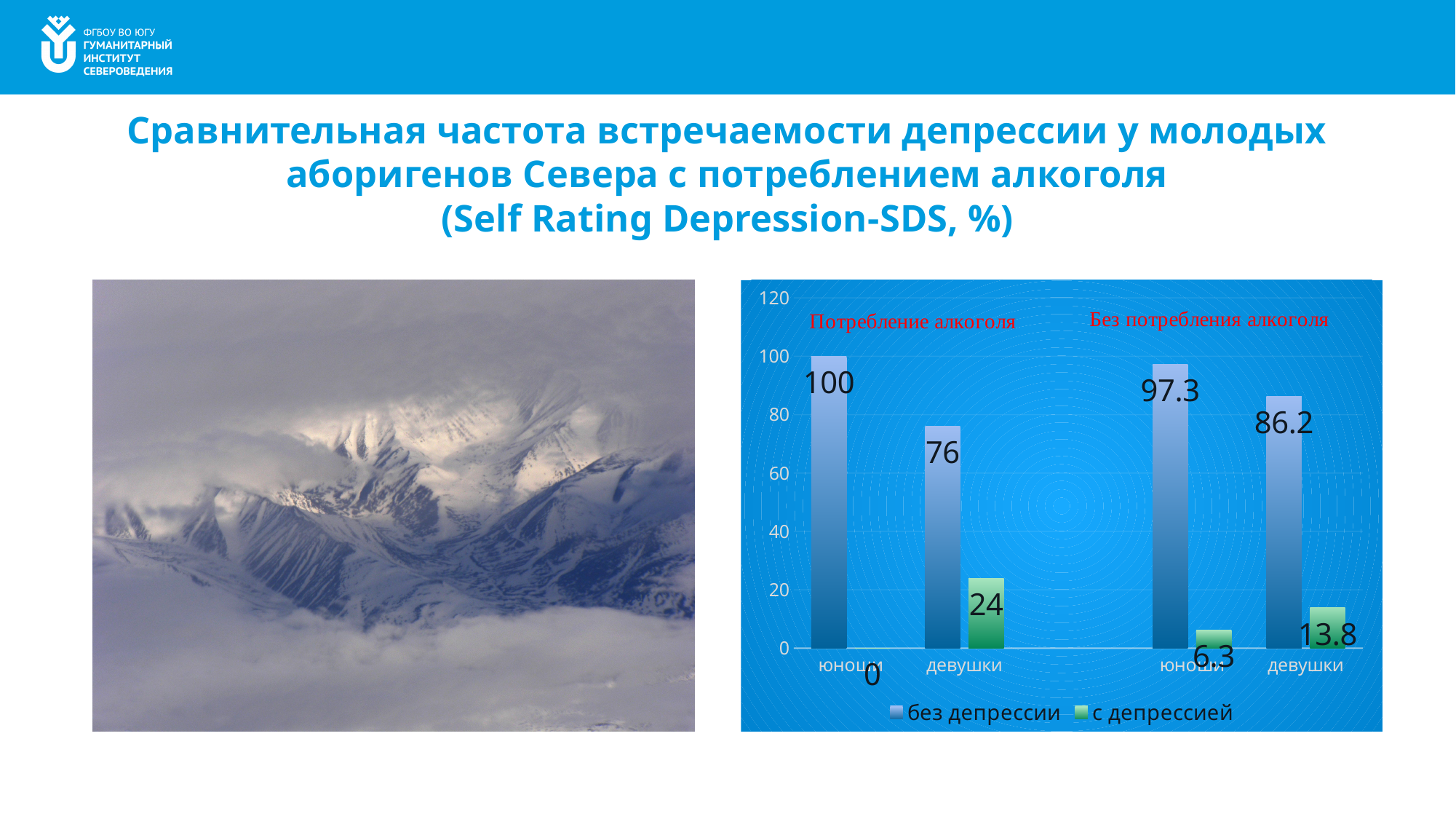
Which is larger: the 'с депрессией' value for девушки in the 'Потребление алкоголя' group or in the 'Без потребления алкоголя' group? Потребление алкоголя What is the difference between the 'без депрессии' values for девушки in the 'Без потребления алкоголя' group (86.2) and the 'Потребление алкоголя' group (76)? 10.2 What is the value for 'без депрессии' for юноши in the 'Потребление алкоголя' group? 100 Is the 'без депрессии' value for девушки in the 'Потребление алкоголя' group greater or less than 80? less What are the two series named in the chart legend? без депрессии, с депрессией What is the value for 'с депрессией' for девушки in the 'Потребление алкоголя' group? 24 What kind of chart is shown on the slide? bar chart How many series does the chart legend list? 2 What is the value for 'с депрессией' for юноши in the 'Без потребления алкоголя' group? 6.3 What is the value for 'без депрессии' for юноши in the 'Без потребления алкоголя' group? 97.3 Which bar has the highest value in the chart? юноши, без депрессии (Потребление алкоголя) What is the value for 'с депрессией' for девушки in the 'Без потребления алкоголя' group? 13.8